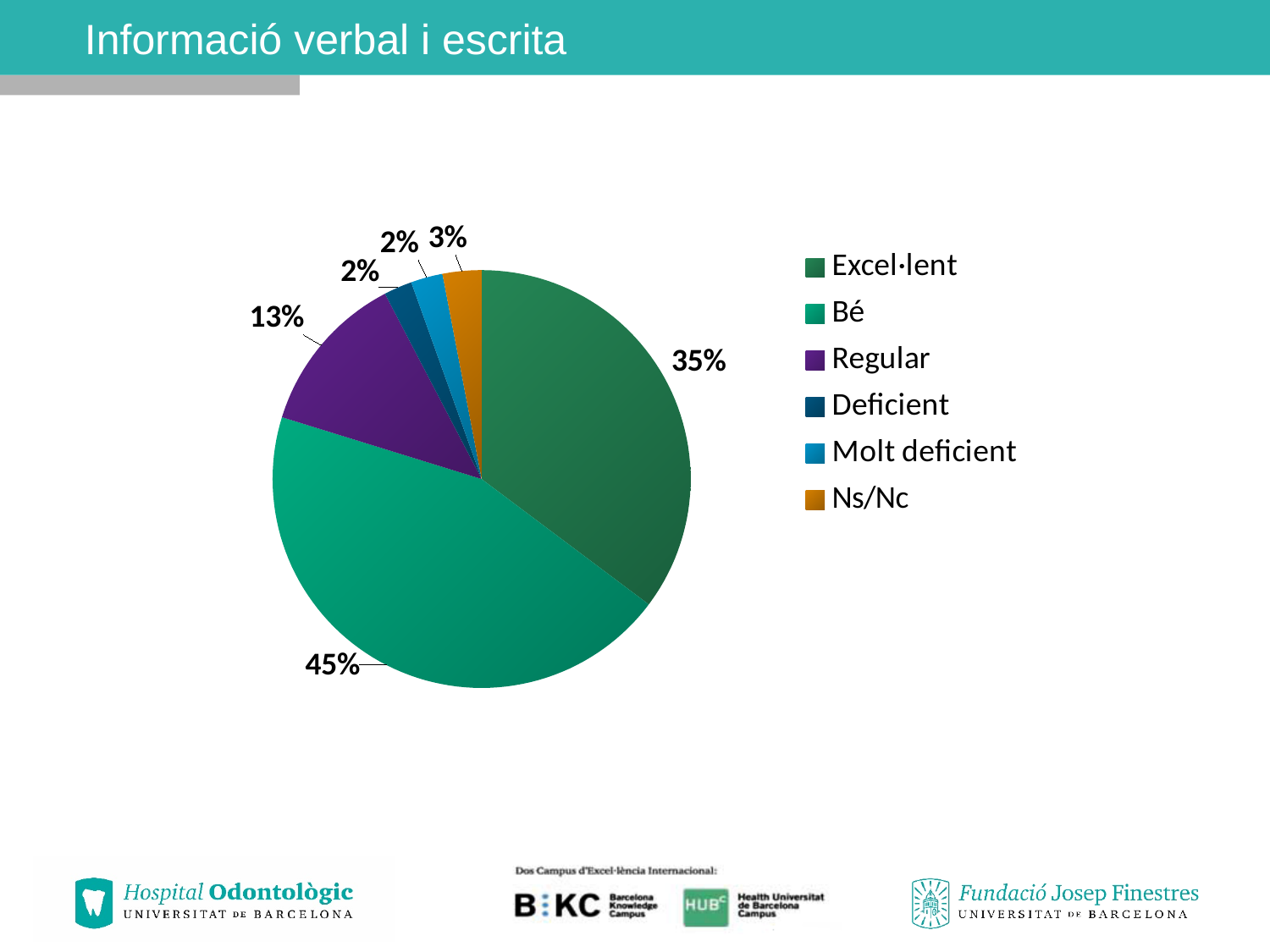
What percentage of the pie corresponds to Deficient? 2% How many categories does the legend list? 6 What is the title of the slide containing the pie chart? Informació verbal i escrita What percentage of the pie corresponds to Ns/Nc? 3% What is the combined share of Excel·lent and Bé? 80% What is the difference in percentage points between Bé and Excel·lent? 10 What percentage of the pie corresponds to Bé? 45% Which category is larger, Excel·lent or Regular? Excel·lent Which category has the largest share of the pie? Bé What type of chart is shown on the slide? pie chart What percentage of the pie corresponds to Regular? 13% What percentage of the pie corresponds to Excel·lent? 35%